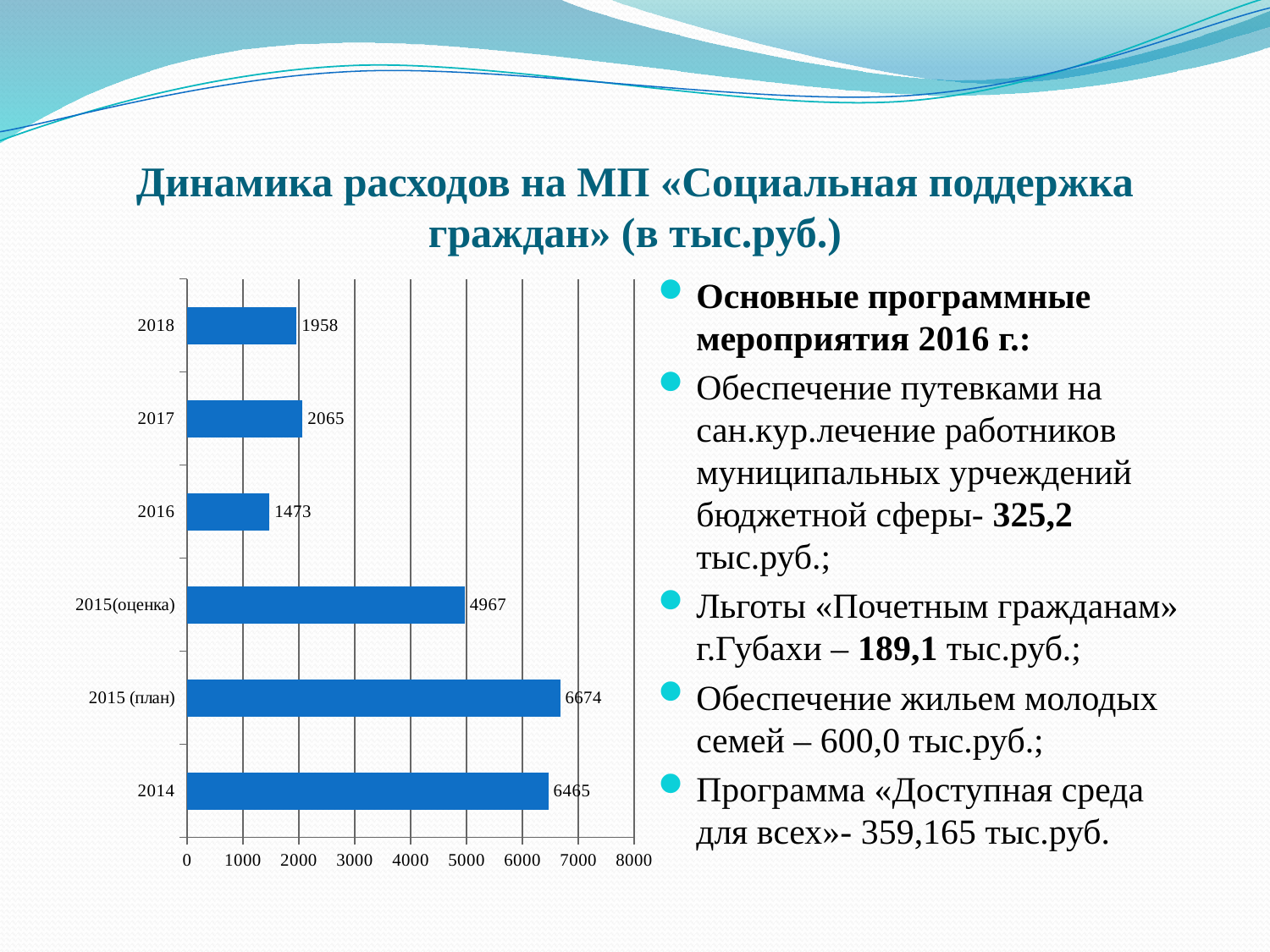
Which is larger, the value for 2017 or the value for 2018? 2017 Is the value for 2014 greater or less than 6000? greater What is the difference between the values for 2015 (план) and 2015(оценка)? 1707 What is the value for 2015(оценка)? 4967 What is the value for 2016? 1473 Which category has the lowest value? 2016 What is the value for 2015 (план)? 6674 Which category has the highest value? 2015 (план) What kind of chart is shown on the slide? bar chart What is the value for 2018? 1958 What is the difference between the values for 2014 and 2016? 4992 How many categories are shown on the chart? 6